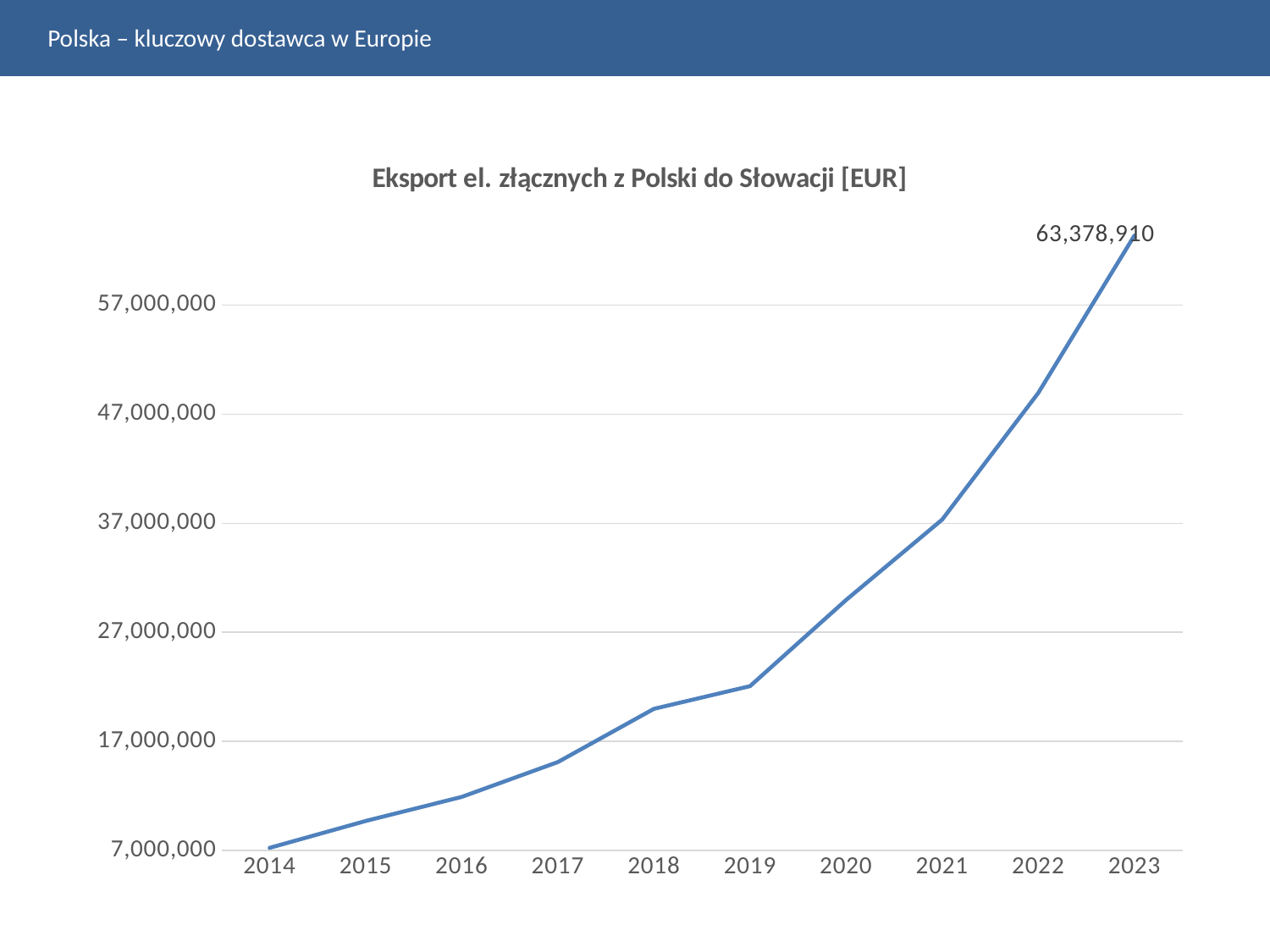
Is the value for 2018 greater or less than 27,000,000? less Which year has the lowest value? 2014 Which is larger, the value for 2020 or the value for 2017? 2020 Is the value for 2022 greater or less than 47,000,000? greater How many years are shown on the x axis? 10 Do the values rise or fall from 2014 to 2023? rise Is the value for 2021 greater or less than 27,000,000? greater What kind of chart is this? line chart What is the title of the chart? Eksport el. złącznych z Polski do Słowacji [EUR] Which year has the highest value? 2023 What is the value for 2023? 63,378,910